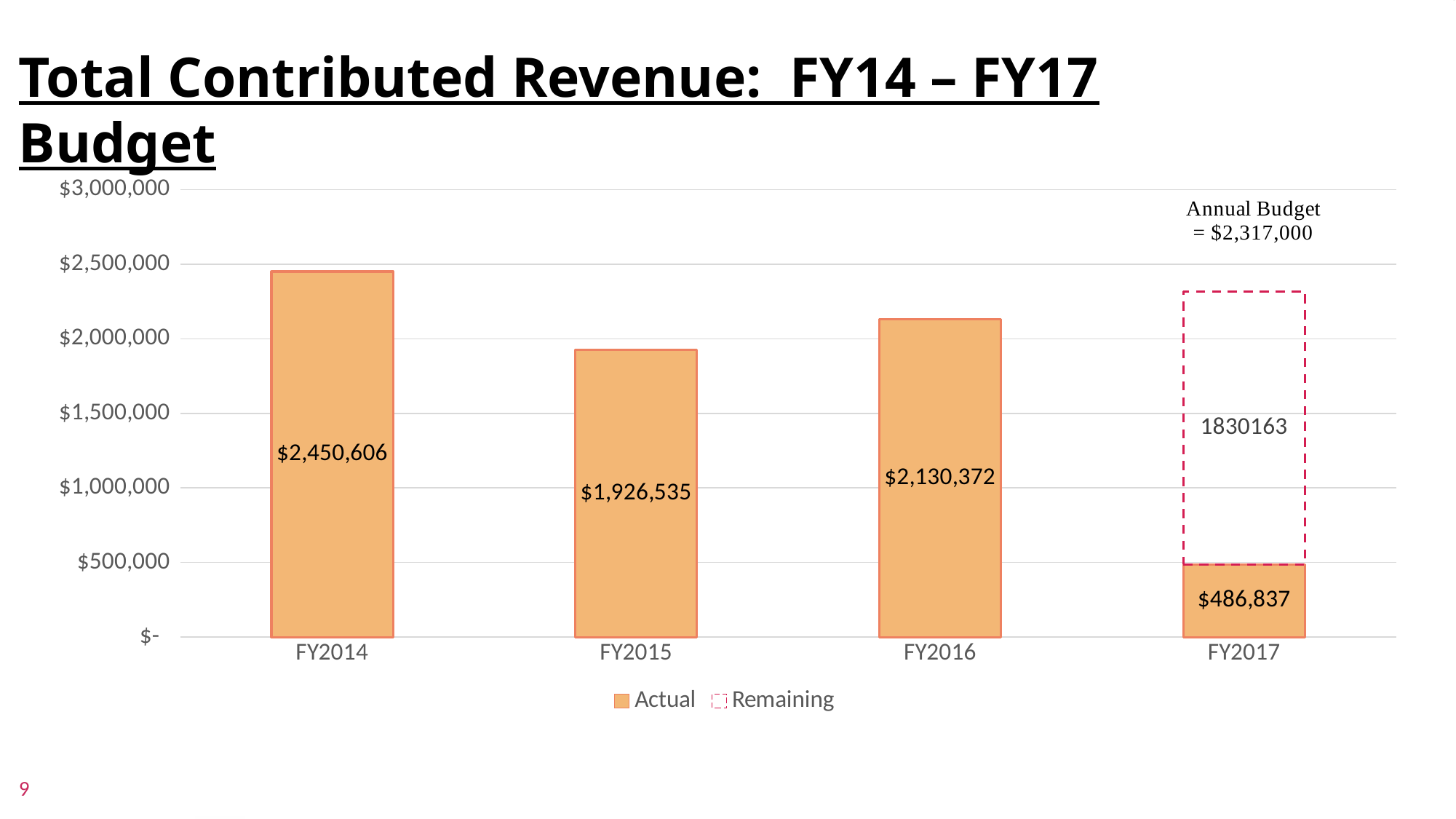
How many series does the legend list? 2 What is the Actual value for FY2016? $2,130,372 What is the total of the FY2017 stacked bar (Actual plus Remaining)? $2,317,000 Which is larger, the Actual value for FY2016 or for FY2015? FY2016 What is the Actual value for FY2015? $1,926,535 What is the Actual value for FY2017? $486,837 What is the difference between the Actual values for FY2014 and FY2015? $524,071 What kind of chart is shown on the slide? Bar chart Which fiscal year has the highest Actual value? FY2014 What is the Remaining value shown for FY2017? 1830163 What is the Actual value for FY2014? $2,450,606 Which fiscal year has the lowest Actual value? FY2017